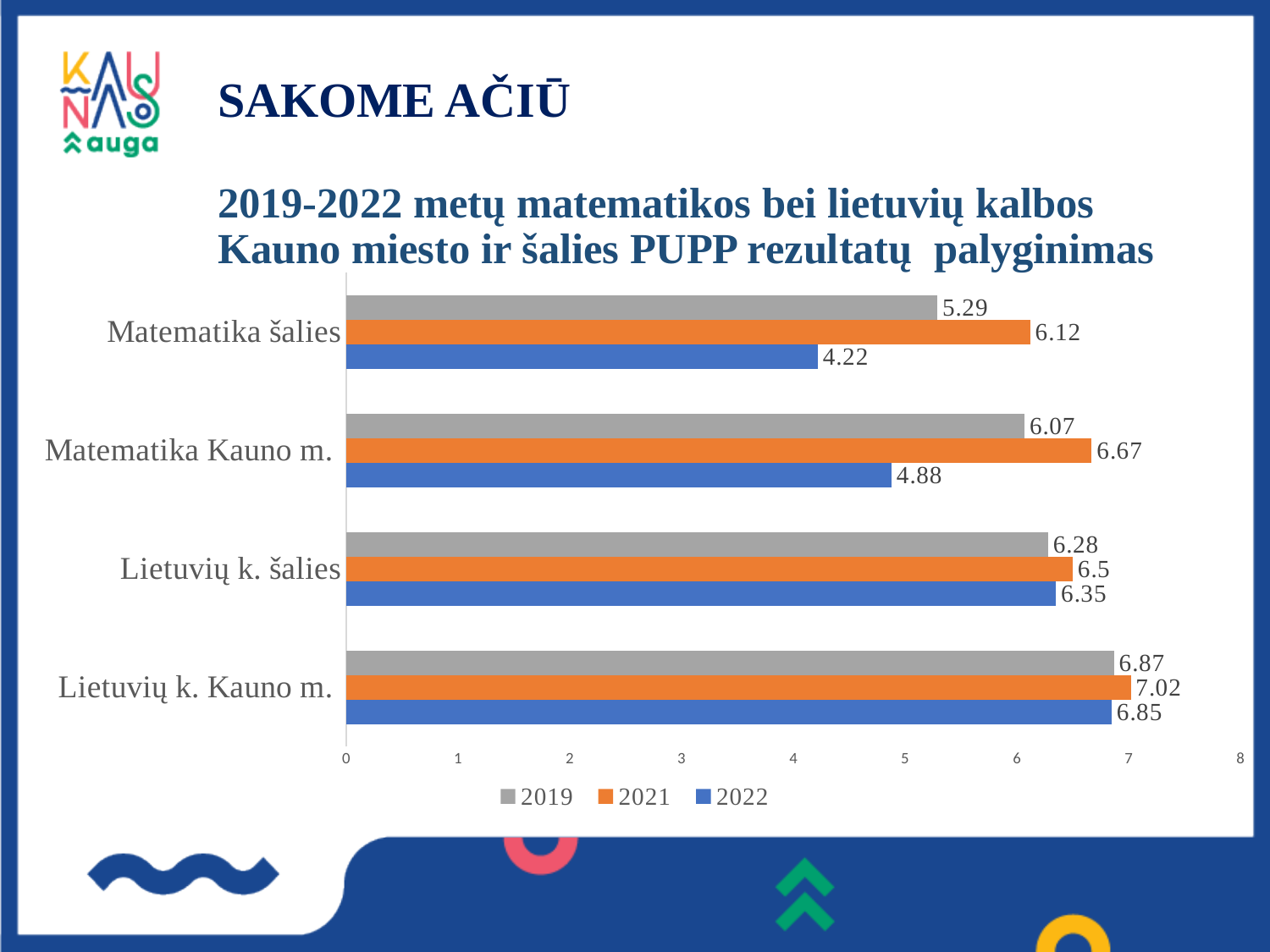
How many series does the legend list? 3 Which is larger: the 2019 value for Matematika šalies or the 2019 value for Matematika Kauno m.? Matematika Kauno m. What is the 2022 value for Matematika šalies? 4.22 What kind of chart is shown on the slide? Bar chart What is the 2021 value for Matematika Kauno m.? 6.67 Which category has the lowest 2022 value? Matematika šalies What is the 2021 value for Lietuvių k. Kauno m.? 7.02 Which category has the highest 2021 value? Lietuvių k. Kauno m. Which series is shown in orange in the legend? 2021 What is the 2019 value for Lietuvių k. šalies? 6.28 How many categories are shown on the chart? 4 What is the difference between the 2021 and 2022 values for Matematika Kauno m.? 1.79